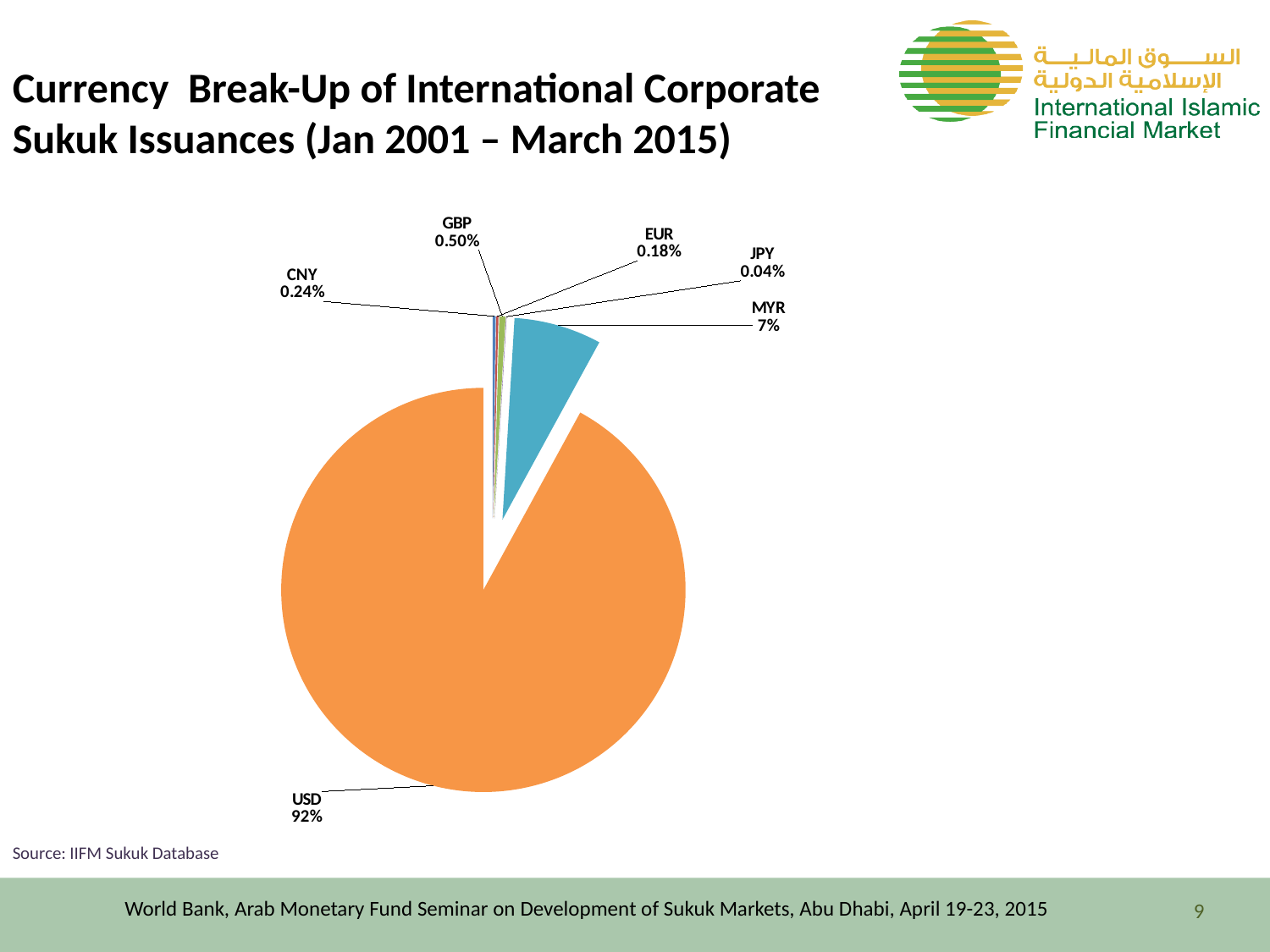
What type of chart is used on this slide? Pie chart What share of international corporate sukuk issuances is in JPY? 0.04% What share of international corporate sukuk issuances is in CNY? 0.24% What share of international corporate sukuk issuances is in EUR? 0.18% Which has a larger share, CNY or EUR? CNY What is the difference in percentage points between the USD share and the MYR share? 85 What share of international corporate sukuk issuances is in USD? 92% Which currency has the smallest share of international corporate sukuk issuances? JPY What share of international corporate sukuk issuances is in GBP? 0.50% Which currency has the largest share of international corporate sukuk issuances? USD What share of international corporate sukuk issuances is in MYR? 7% How many currencies are shown in the pie chart? 6